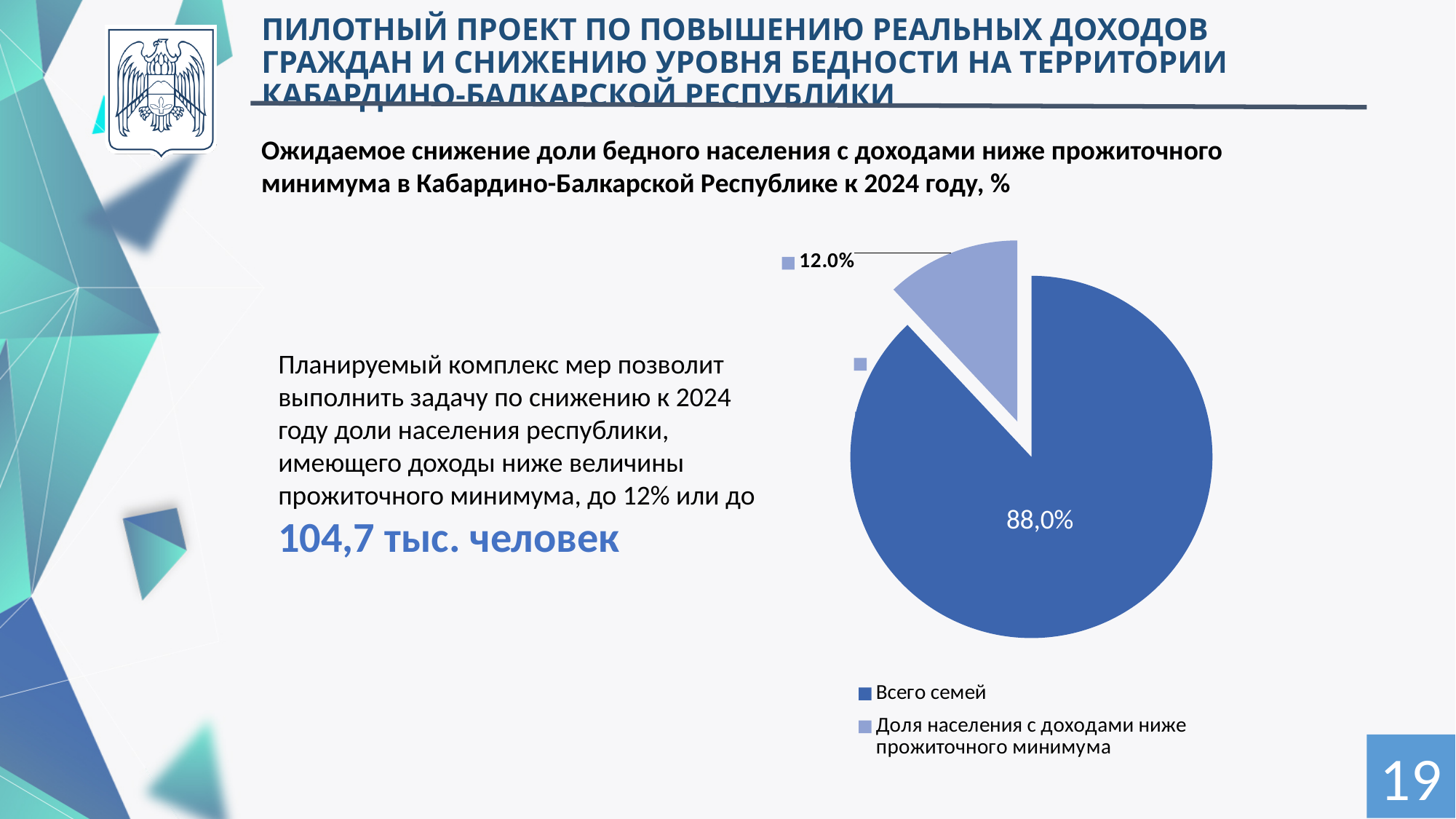
Which slice of the pie chart is pulled out (exploded) from the rest of the pie? Доля населения с доходами ниже прожиточного минимума How many slices does the pie chart have? 2 What value is shown for the slice "Доля населения с доходами ниже прожиточного минимума"? 12.0% What kind of chart is shown on the slide? pie chart How many entries does the legend of the pie chart list? 2 Which slice of the pie chart is the smallest? Доля населения с доходами ниже прожиточного минимума What share of the pie does the "Доля населения с доходами ниже прожиточного минимума" slice represent? 12.0% Which slice of the pie chart is the largest? Всего семей What is the difference in percentage points between the "Всего семей" slice and the "Доля населения с доходами ниже прожиточного минимума" slice? 76 What value is shown for the slice "Всего семей"? 88,0% Which is larger: the slice for "Всего семей" or the slice for "Доля населения с доходами ниже прожиточного минимума"? Всего семей What colour is the slice for "Всего семей" in the pie chart? dark blue